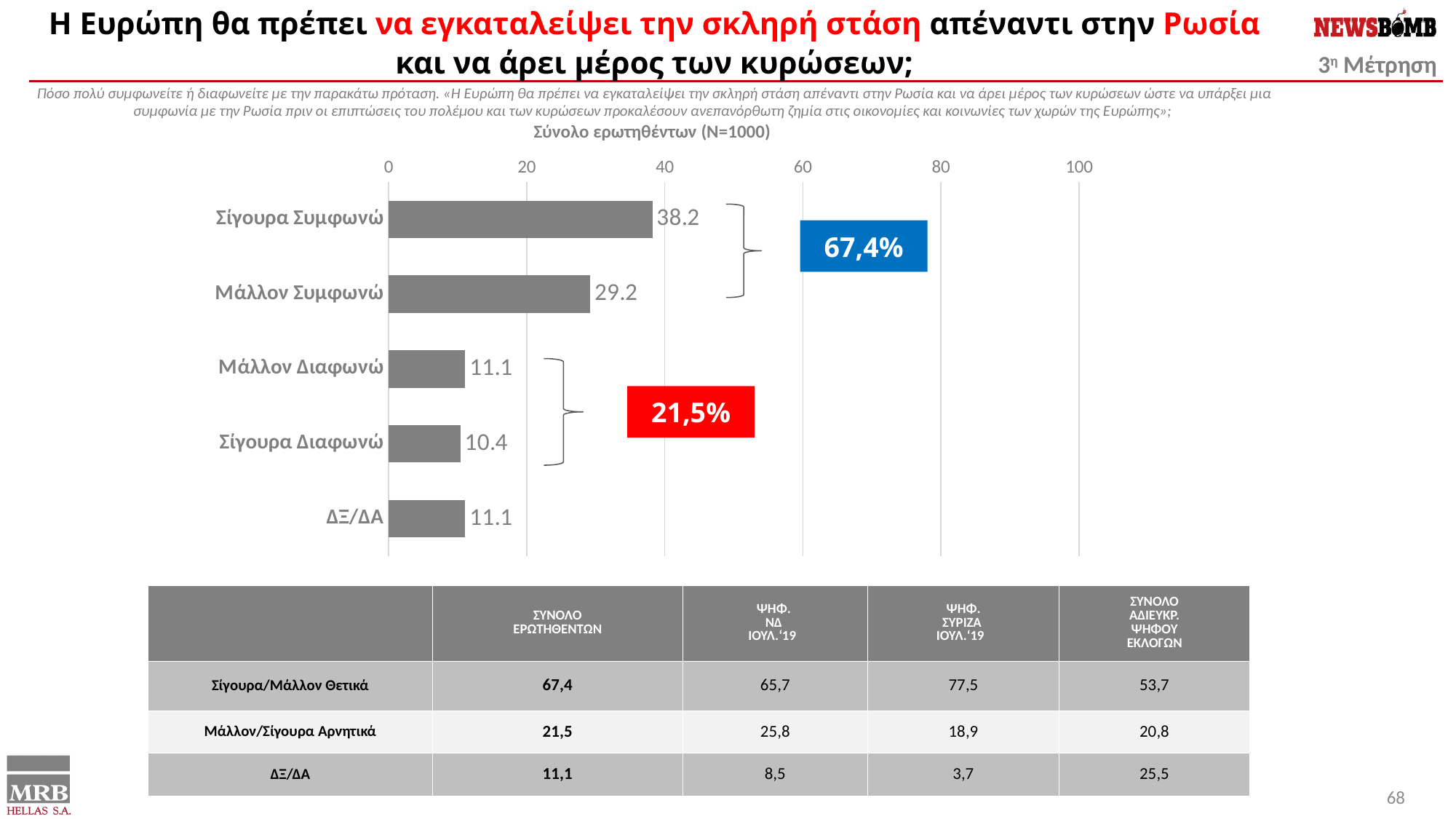
Which category has the highest value in the bar chart? Σίγουρα Συμφωνώ What value is shown for Σίγουρα Συμφωνώ in the bar chart? 38.2 What type of chart is shown on the slide? bar chart Which is larger, the value for Μάλλον Συμφωνώ or the value for Μάλλον Διαφωνώ? Μάλλον Συμφωνώ What percentage is shown in the blue callout box next to the agree bars? 67,4% What value is shown for Σίγουρα Διαφωνώ in the bar chart? 10.4 What value is shown for Μάλλον Συμφωνώ in the bar chart? 29.2 What value is shown for ΔΞ/ΔΑ in the bar chart? 11.1 Which category has the lowest value in the bar chart? Σίγουρα Διαφωνώ What is the difference between the values for Σίγουρα Συμφωνώ and Μάλλον Συμφωνώ? 9.0 How many categories are shown in the bar chart? 5 Is the value for Σίγουρα Συμφωνώ greater or less than 40? less